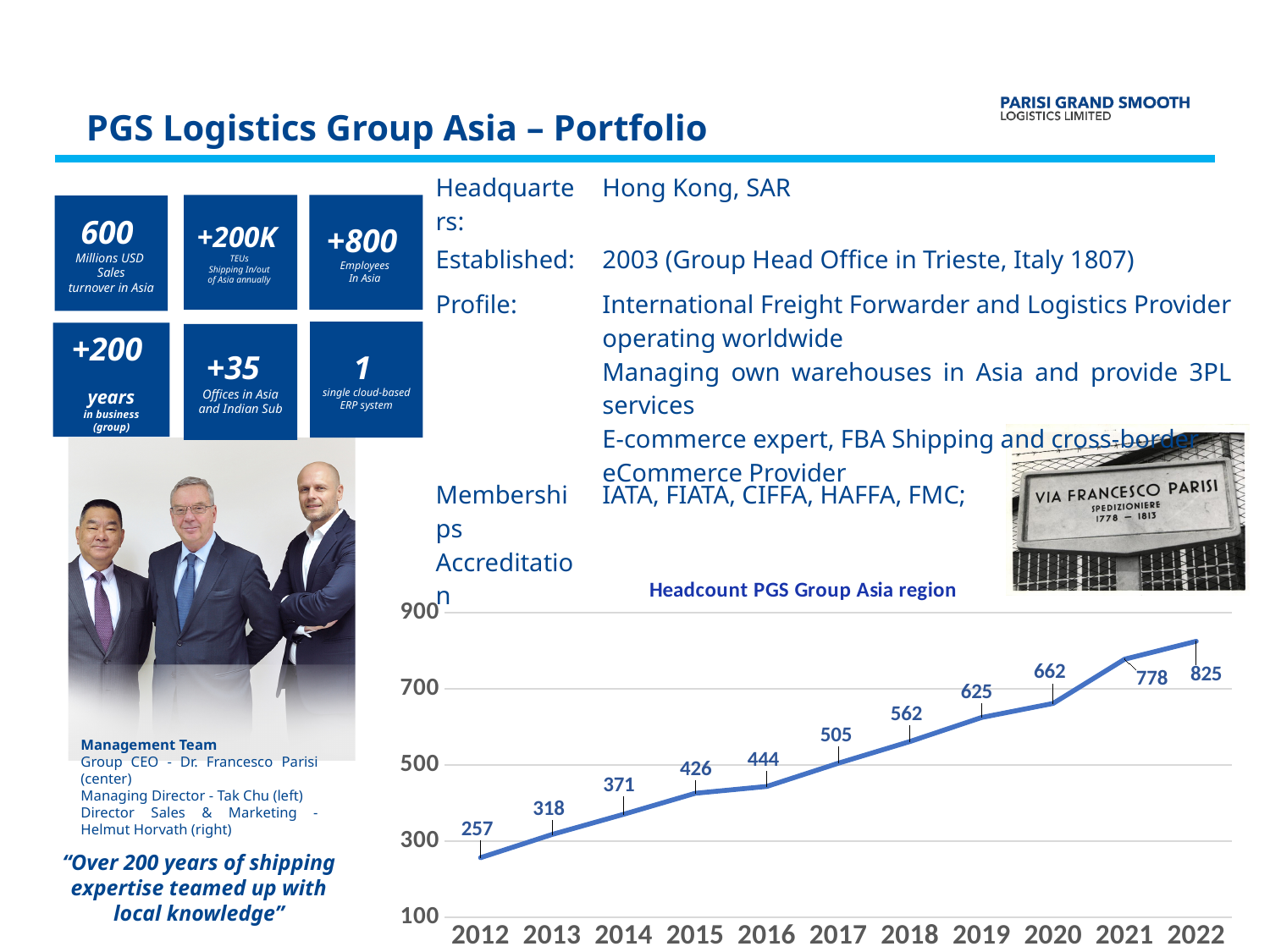
Is the headcount for 2019 greater or less than 500? greater How many years are plotted on the chart? 11 Which year has the lowest headcount? 2012 What is the headcount for 2018? 562 Which year has the highest headcount? 2022 What is the difference in headcount between 2022 and 2012? 568 Which year has a larger headcount, 2016 or 2019? 2019 What is the headcount for 2012? 257 What is the difference in headcount between 2021 and 2020? 116 What is the title of the chart? Headcount PGS Group Asia region What kind of chart is shown? line chart What is the headcount for 2022? 825